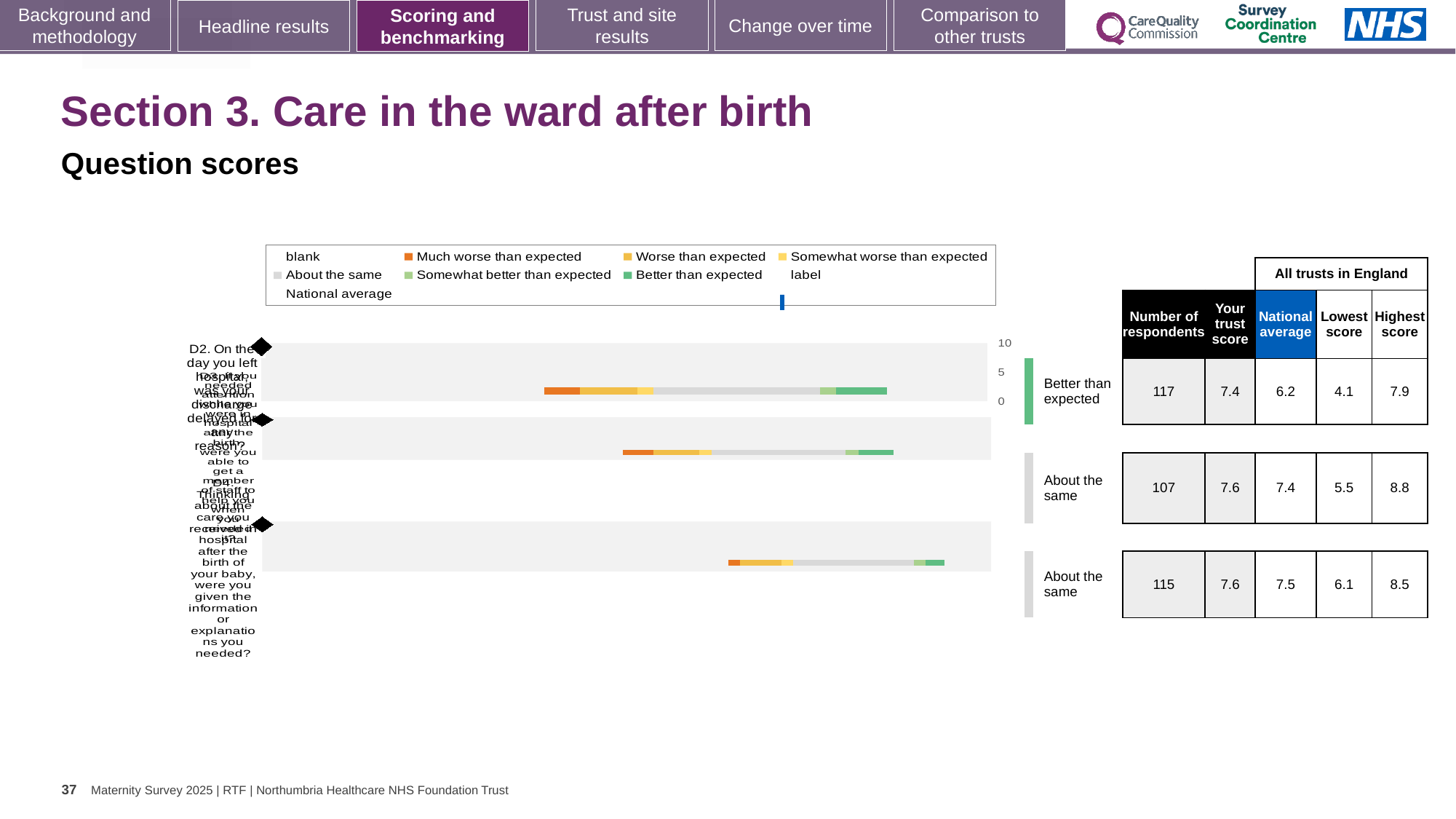
How many horizontal bars are plotted in the chart? 3 In the table to the right of the chart, is the trust score in the second row larger or smaller than the national average in that row? larger In the table to the right of the chart, what is the difference between the trust score and the national average in the first row? 1.2 In the table to the right of the chart, which row has the highest number of respondents: the first, second or third? first What colour does the legend use for "Much worse than expected"? orange In the table to the right of the chart, what is the trust score in the first row (labelled "Better than expected")? 7.4 What kind of chart is shown on the slide? bar chart In the table to the right of the chart, what is the highest score in the second row? 8.8 What colour does the legend use for "Better than expected"? green In the table to the right of the chart, what is the national average in the first row (labelled "Better than expected")? 6.2 In the table to the right of the chart, what is the lowest score in the third row? 6.1 In the table to the right of the chart, what is the number of respondents in the first row (labelled "Better than expected")? 117